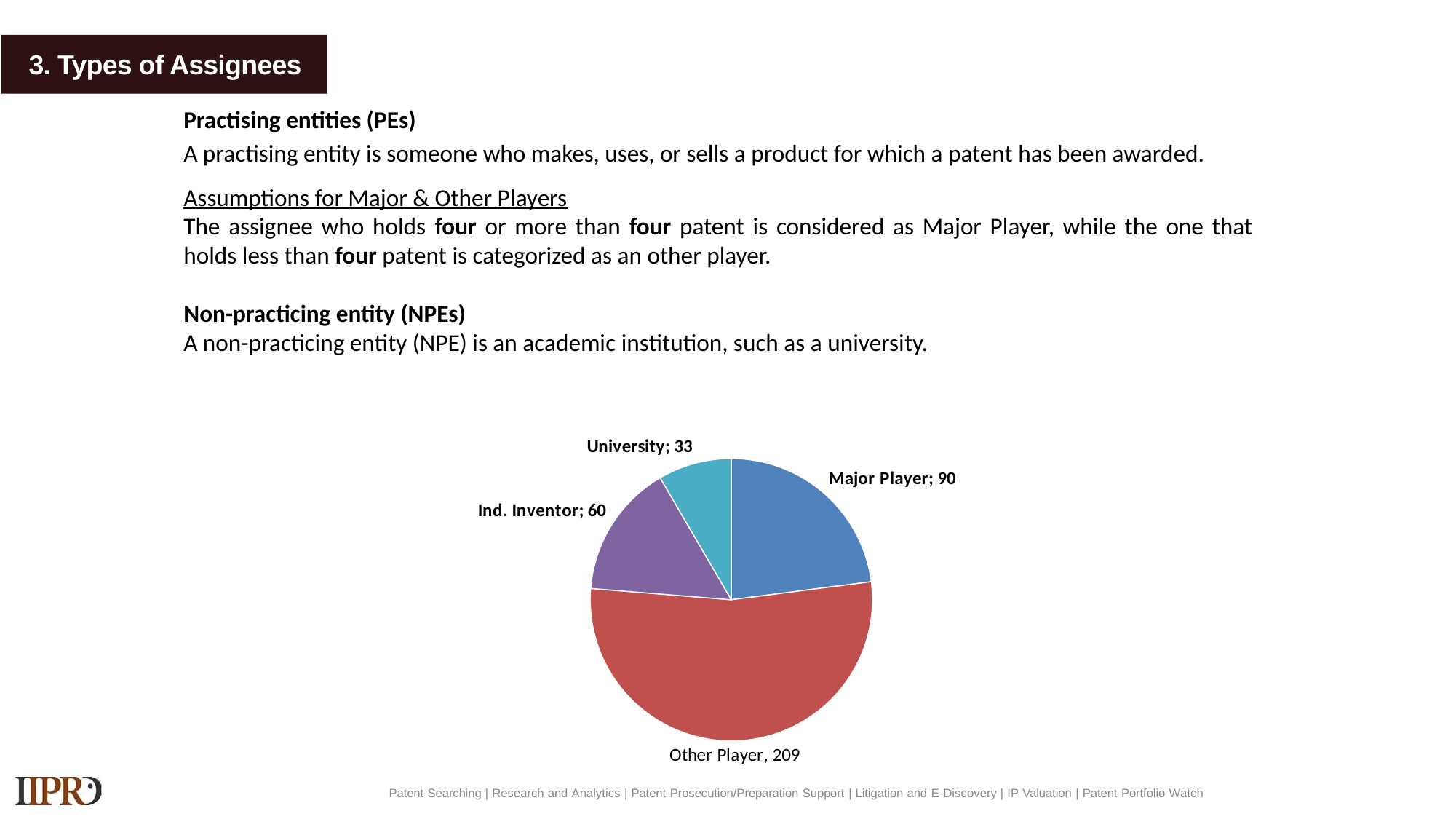
What is the total of all slices in the pie chart? 392 Which category has the largest slice in the pie chart? Other Player What kind of chart is shown on the slide? Pie chart What is the value for Major Player in the pie chart? 90 What is the value for Ind. Inventor in the pie chart? 60 How many categories are shown in the pie chart? 4 What is the value for Other Player in the pie chart? 209 What is the value for University in the pie chart? 33 What share of the pie does Other Player represent? 53.3% Which is larger, the value for Ind. Inventor or the value for University? Ind. Inventor Which category has the smallest slice in the pie chart? University What is the difference between the values for Other Player and Major Player? 119